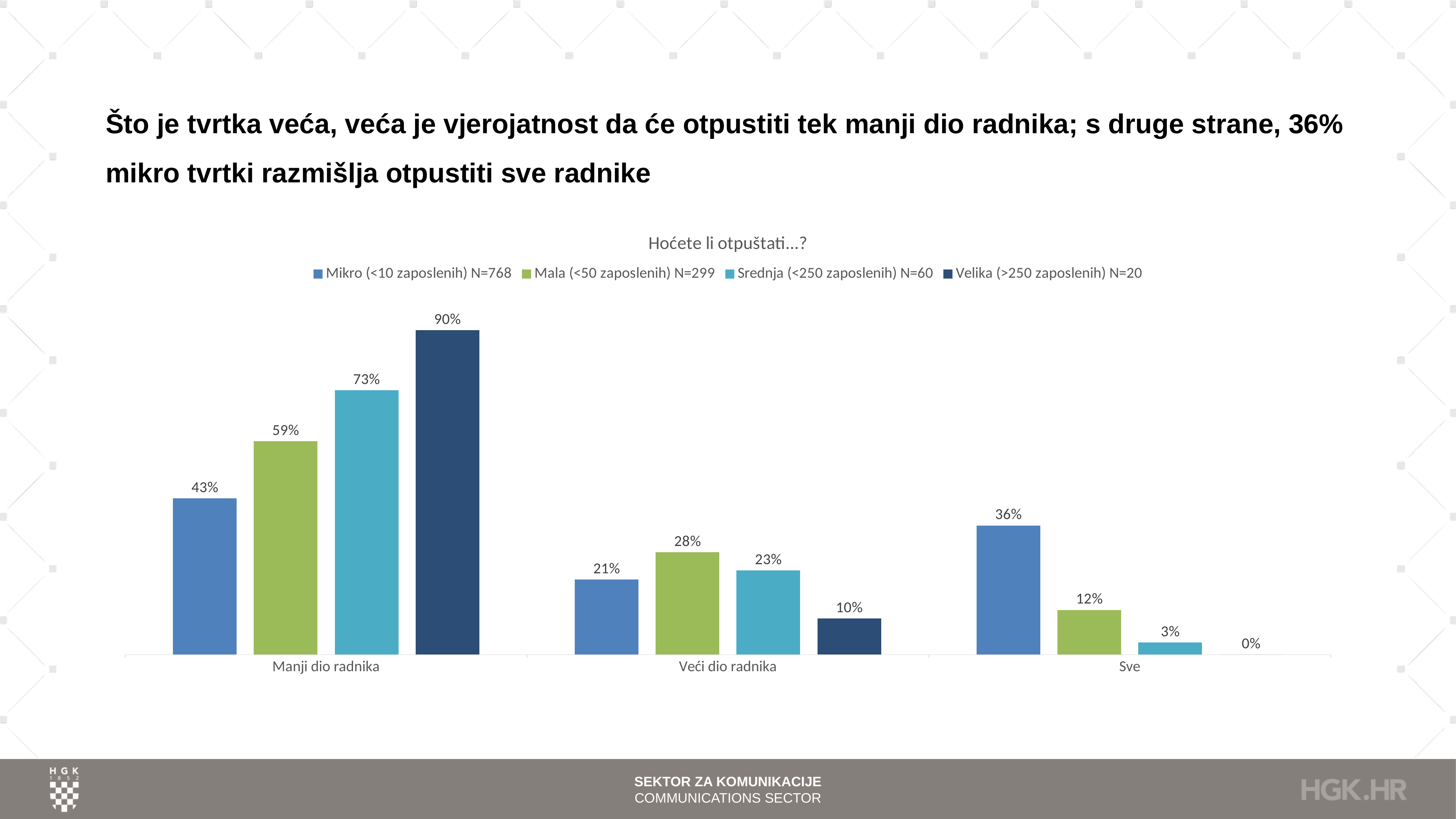
What is the value for Srednja (<250 zaposlenih) N=60 in the Veći dio radnika category? 23% How many categories are shown on the x axis? 3 In the Veći dio radnika category, which is larger: the Mala value or the Mikro value? Mala (<50 zaposlenih) N=299 What is the title of the chart? Hoćete li otpuštati…? Which series has the lowest value in the Sve category? Velika (>250 zaposlenih) N=20 What kind of chart is shown on the slide? Bar chart Which series has the highest value in the Manji dio radnika category? Velika (>250 zaposlenih) N=20 How many series does the legend list? 4 What is the value for Mikro (<10 zaposlenih) N=768 in the Sve category? 36% What is the value for Velika (>250 zaposlenih) N=20 in the Manji dio radnika category? 90% Do the values for Velika (>250 zaposlenih) N=20 rise or fall from Manji dio radnika to Sve? Fall What is the difference between the Velika and Mikro values in the Manji dio radnika category? 47%